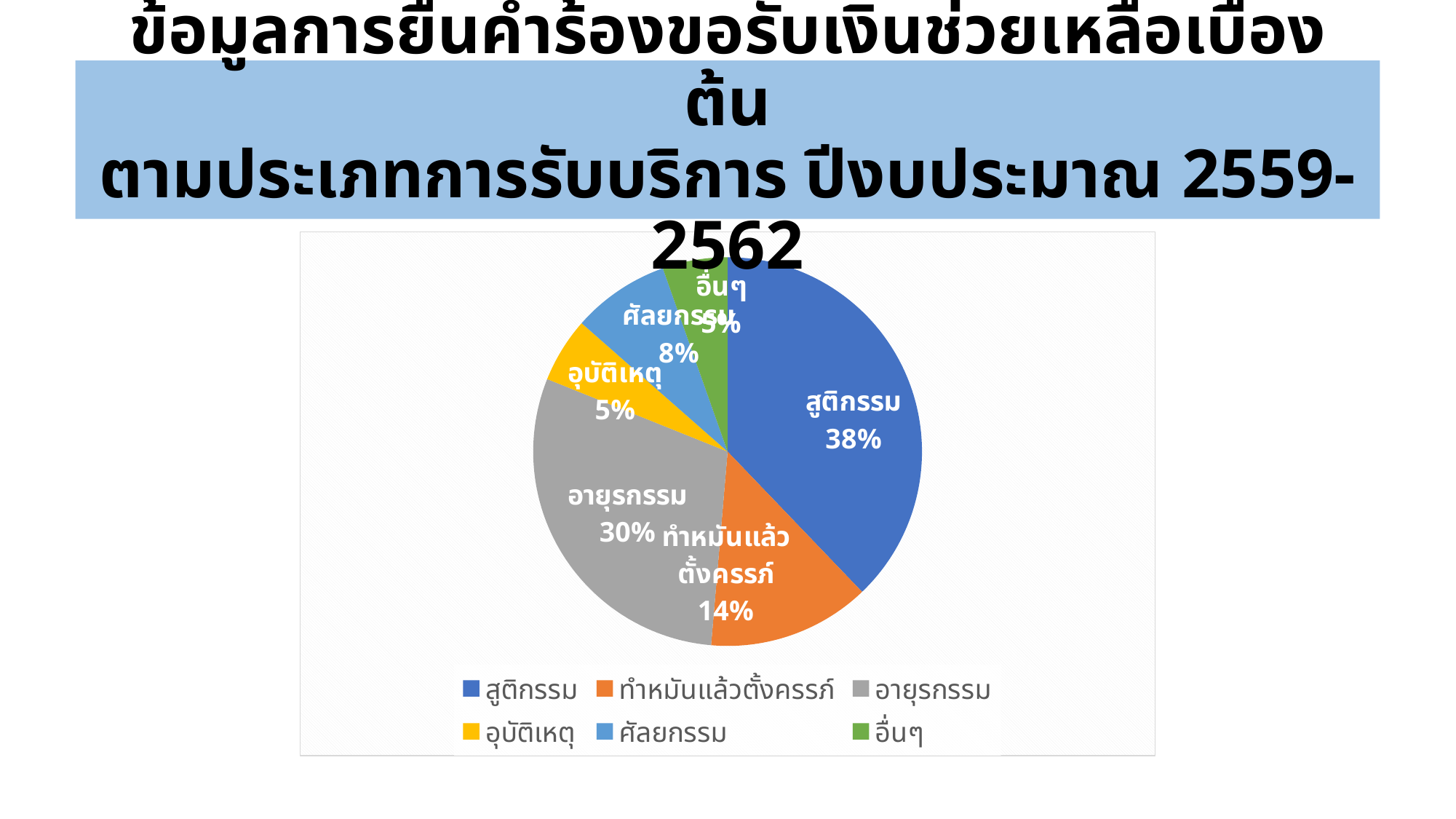
Which is larger, ศัลยกรรม or อุบัติเหตุ? ศัลยกรรม What is the value labelled for ศัลยกรรม? 8% Which category has the largest slice of the pie chart? สูติกรรม What is the value shown for อายุรกรรม in the pie chart? 30% What colour is the สูติกรรม slice in the pie chart? Blue What is the difference between อายุรกรรม and ทำหมันแล้วตั้งครรภ์? 16 percentage points What percentage is shown for ทำหมันแล้วตั้งครรภ์? 14% How many categories are shown in the pie chart? 6 What percentage does the อุบัติเหตุ slice show? 5% What type of chart is shown on the slide? Pie chart How many percentage points larger is สูติกรรม than อายุรกรรม? 8 percentage points What percentage of the pie chart does สูติกรรม account for? 38%